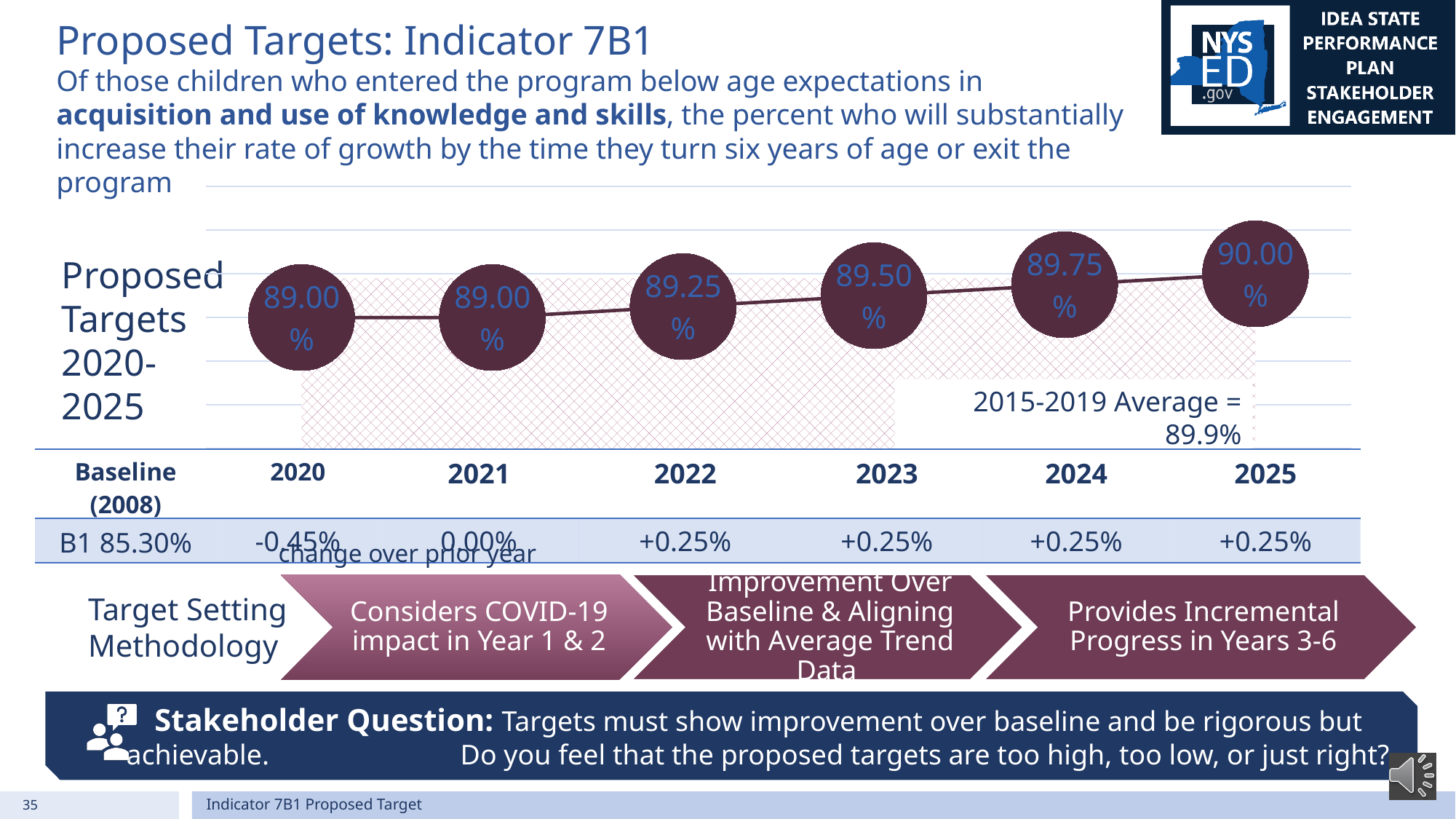
What is the difference between the 2025 target and the 2023 target? 0.50% How many years are plotted on the chart? 6 What is the 2015-2019 average shown on the chart? 89.9% What is the proposed target for 2022? 89.25% What is the proposed target for 2020? 89.00% What is the change over prior year shown for 2020? -0.45% What is the baseline (2008) value shown below the chart? 85.30% Which year has the highest proposed target? 2025 What is the proposed target for 2025? 90.00% Which is larger, the 2024 target or the 2021 target? 2024 target What kind of chart is shown? Combination area and line chart Do the proposed targets rise or fall from 2020 to 2025? Rise